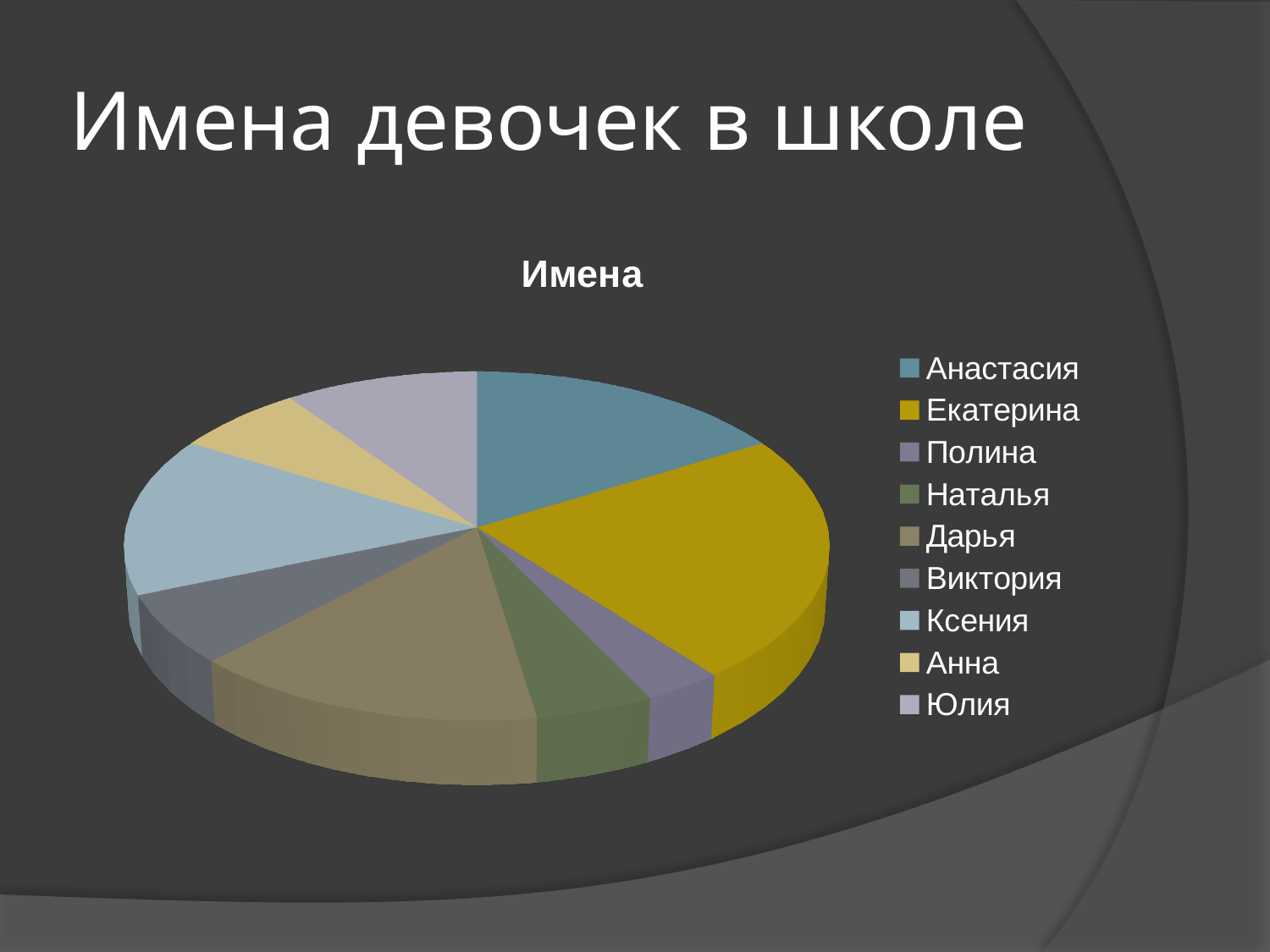
Which name is listed first in the legend? Анастасия Which name has the largest slice of the pie? Екатерина Which slice is larger, Ксения or Наталья? Ксения Which slice is larger, Дарья or Полина? Дарья What kind of chart is shown on the slide? pie chart Which slice is larger, Анастасия or Анна? Анастасия How many names are listed in the chart's legend? 9 What is the title of the chart? Имена